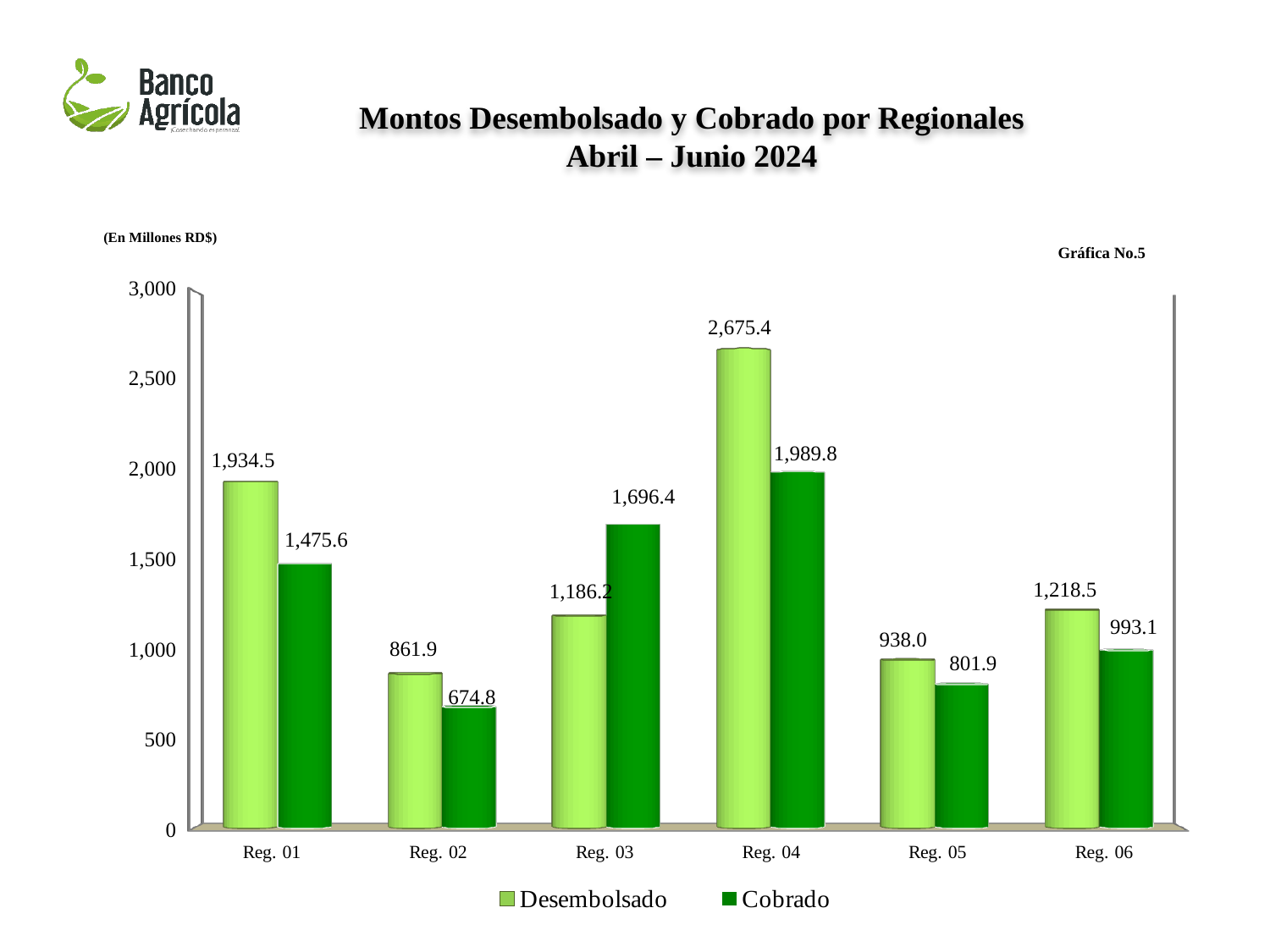
What is the difference between the Desembolsado and Cobrado values for Reg. 01? 458.9 Is the Desembolsado value for Reg. 05 greater or less than 1,000? less What is the Desembolsado value for Reg. 04? 2,675.4 Which region has the highest Desembolsado value? Reg. 04 How many series does the legend list? 2 How many regions are shown on the x axis? 6 Which region has the lowest Cobrado value? Reg. 02 What is the Cobrado value for Reg. 06? 993.1 What unit is stated for the values in the chart? En Millones RD$ What kind of chart is shown on the slide? bar chart For Reg. 03, which is larger, Desembolsado or Cobrado? Cobrado What is the Cobrado value for Reg. 02? 674.8